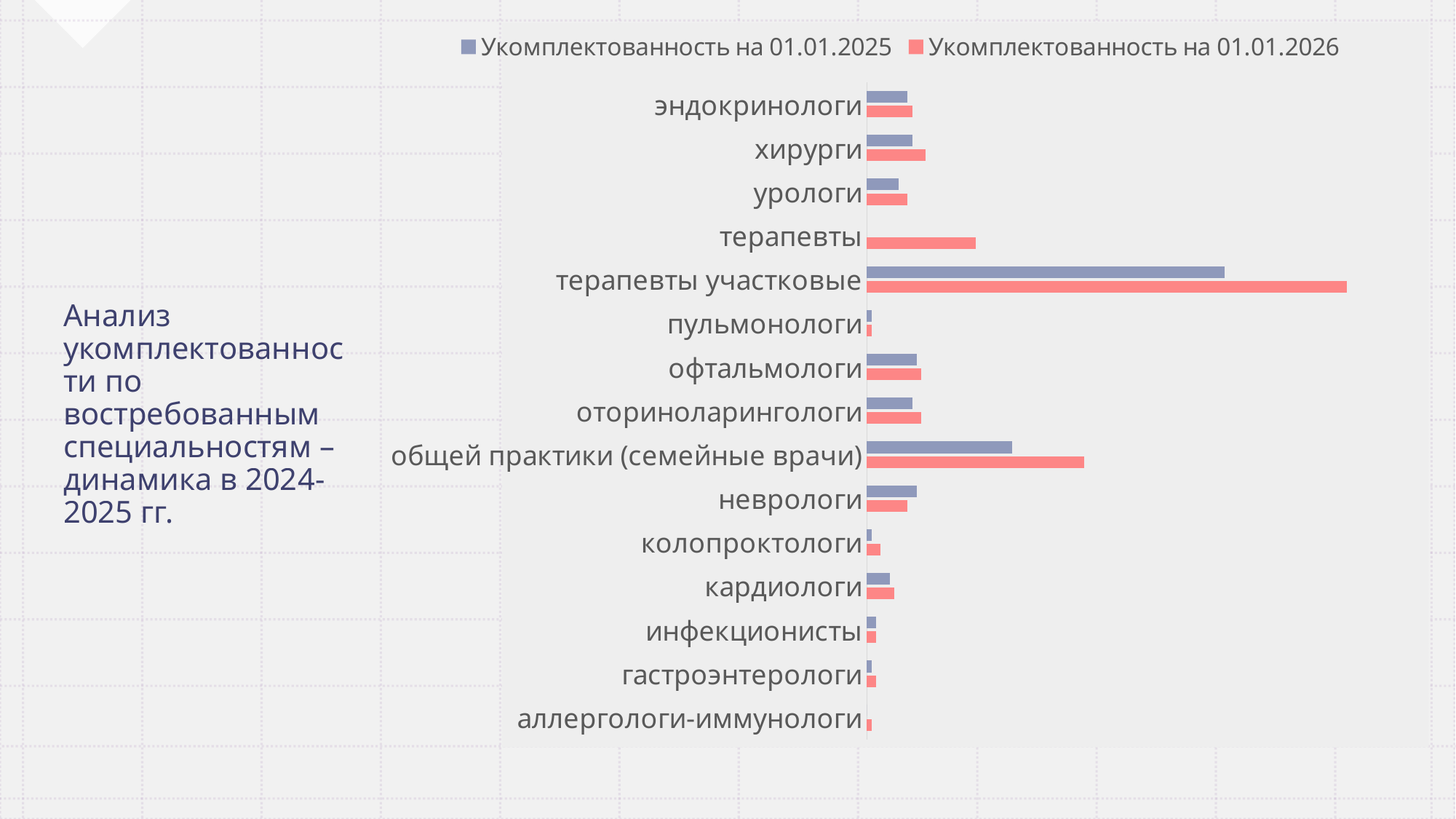
How many series does the legend list? 2 Which category has the highest value for Укомплектованность на 01.01.2025? терапевты участковые For терапевты участковые, which is larger: the value for 01.01.2025 or for 01.01.2026? 01.01.2026 Which colour represents Укомплектованность на 01.01.2026 in the chart? red (pink) Which category has the highest value for Укомплектованность на 01.01.2026? терапевты участковые What kind of chart is shown on the slide? bar chart For Укомплектованность на 01.01.2025, which is larger: общей практики (семейные врачи) or офтальмологи? общей практики (семейные врачи) For Укомплектованность на 01.01.2026, which is larger: терапевты or пульмонологи? терапевты What are the two legend entries of the chart? Укомплектованность на 01.01.2025; Укомплектованность на 01.01.2026 How many specialty categories are plotted on the chart? 15